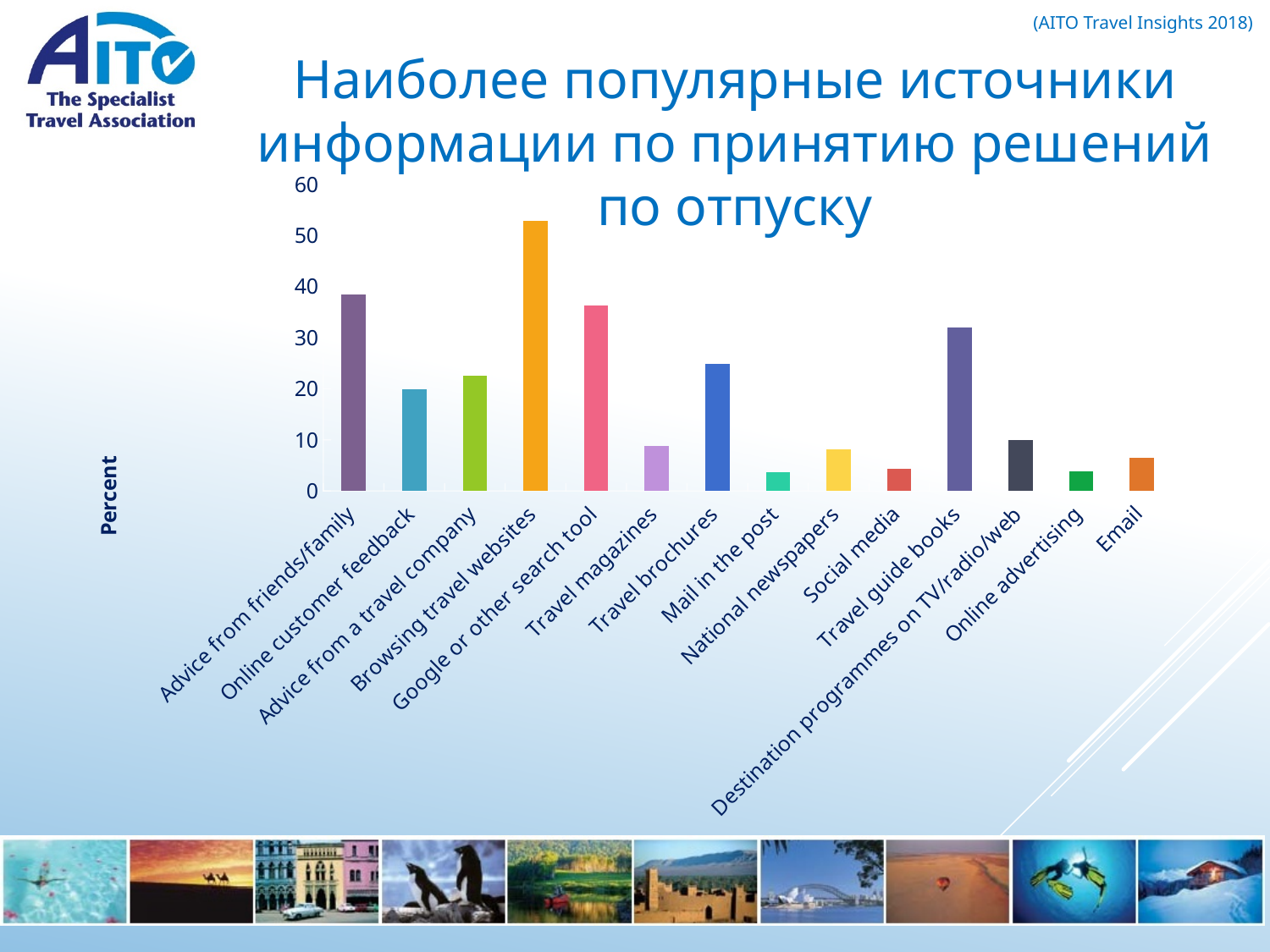
What is the label on the vertical axis of the chart? Percent What kind of chart is shown on the slide? bar chart Which is larger, the value for Browsing travel websites or the value for Google or other search tool? Browsing travel websites Is the value for Travel guide books greater or less than 30? greater Which is larger, the value for Travel guide books or the value for Travel brochures? Travel guide books Which category has the highest value? Browsing travel websites Is the value for Travel brochures greater or less than 20? greater Is the value for Browsing travel websites greater or less than 50? greater How many categories are plotted on the x axis? 14